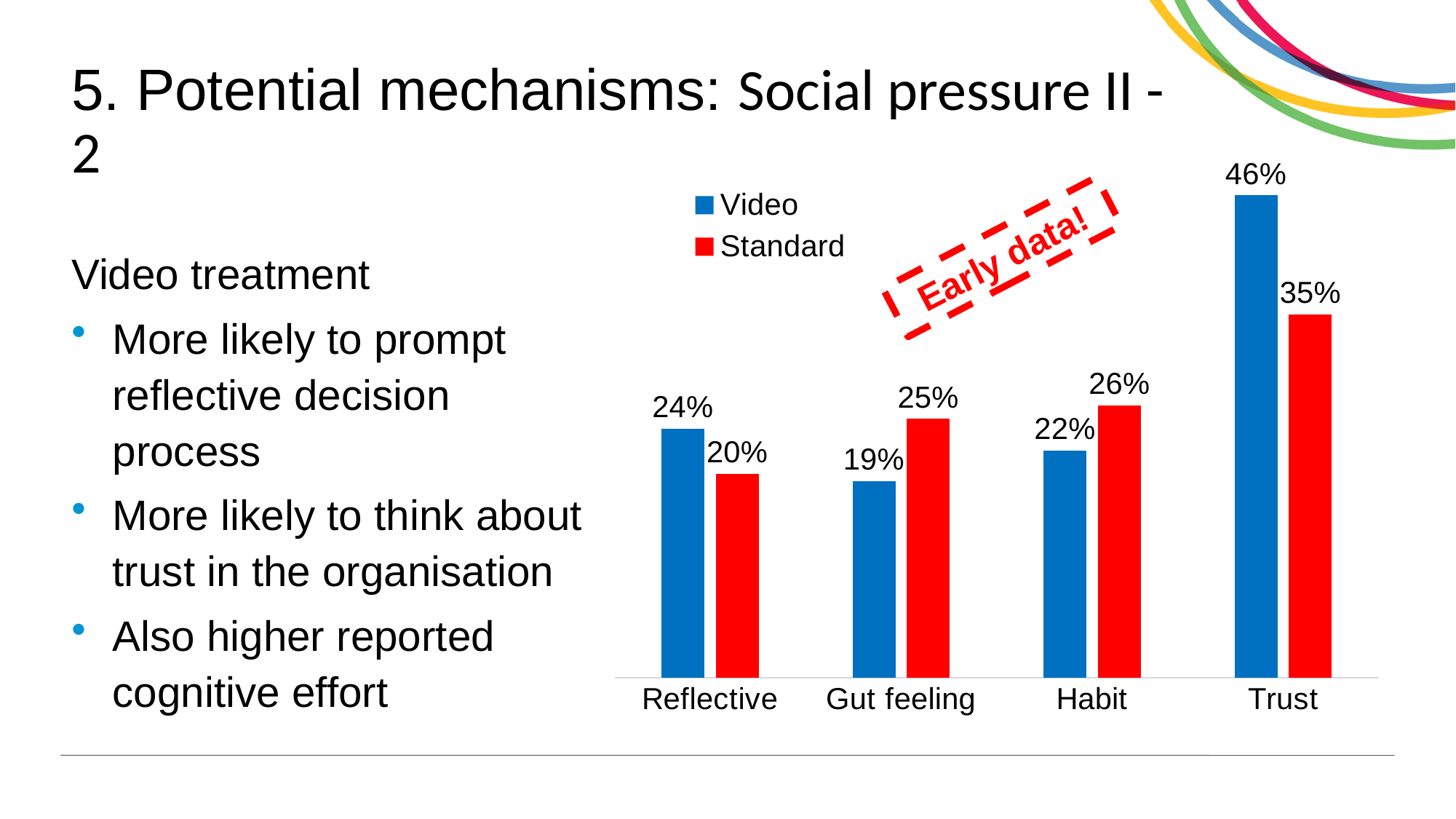
What is the difference between the Video and Standard values for Trust? 11% How many series does the legend list? 2 What is the Standard value for Reflective? 20% What kind of chart is shown on the slide? Bar chart What is the Video value for Habit? 22% What is the Standard value for Gut feeling? 25% Which category has the highest Video value? Trust What is the Video value for Trust? 46% Which category has the lowest Video value? Gut feeling Which colour represents the Standard series in the chart? Red Which is larger for Reflective, the Video value or the Standard value? Video How many categories are shown on the x axis? 4